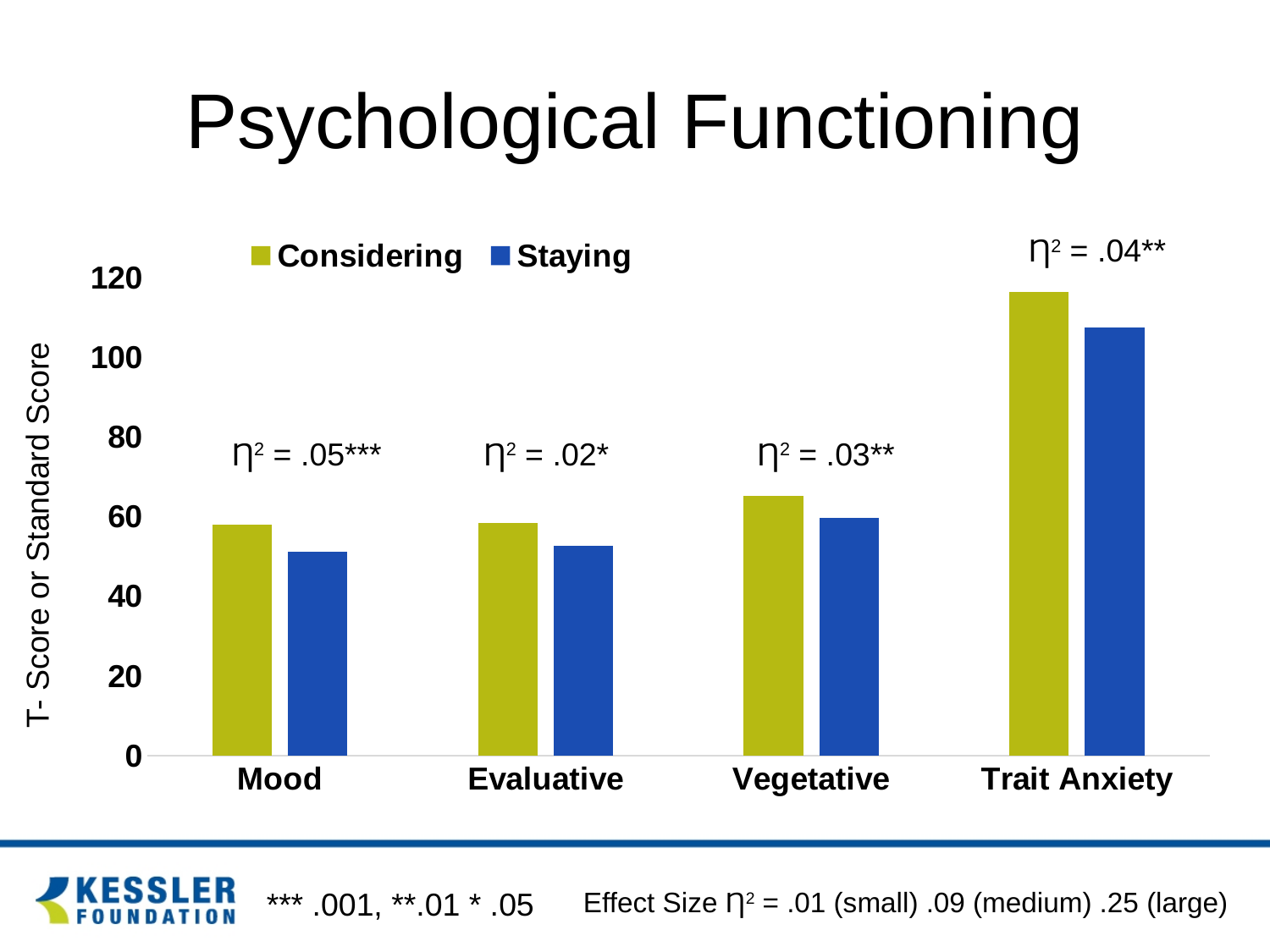
What is the y-axis label of the chart? T- Score or Standard Score How many series does the legend list? 2 Which is larger, the Considering value for Vegetative or the Considering value for Mood? Vegetative Is the Staying value for Trait Anxiety greater or less than 100? greater How many categories are shown on the x axis? 4 What is the title of the chart? Psychological Functioning Is the Considering value for Trait Anxiety greater or less than 100? greater For Trait Anxiety, which series has the larger value, Considering or Staying? Considering Is the Staying value for Mood greater or less than 60? less What kind of chart is shown on the slide? Bar chart Which category has the highest bars? Trait Anxiety